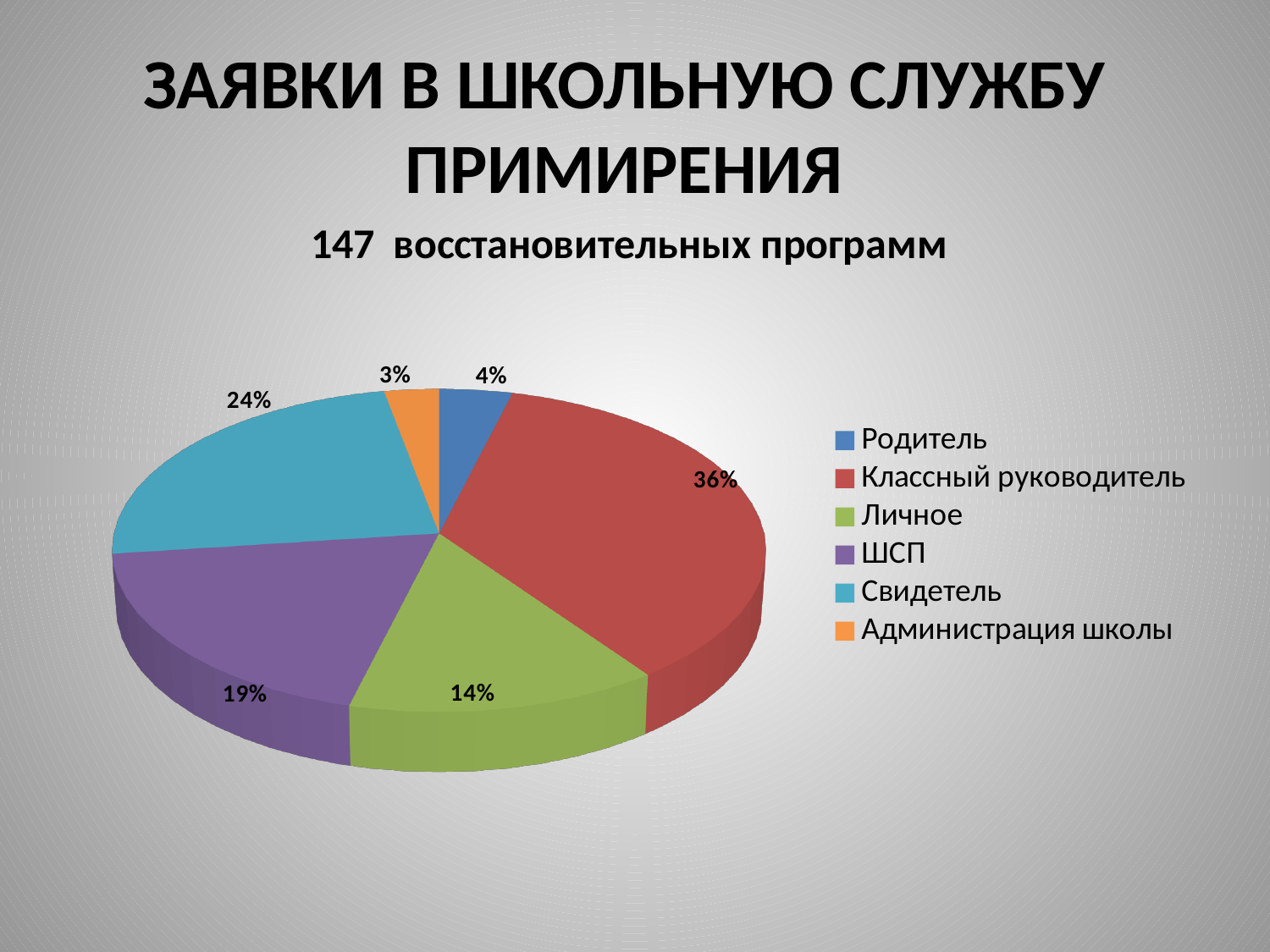
What share of the pie does Родитель have? 4% What share of the pie does Личное have? 14% How many categories does the legend list? 6 Which is larger, the share for ШСП or the share for Личное? ШСП What is the difference in percentage points between Классный руководитель and Свидетель? 12 What share of the pie does Свидетель have? 24% Which category has the smallest slice of the pie? Администрация школы Which category has the largest slice of the pie? Классный руководитель What kind of chart is shown on the slide? Pie chart